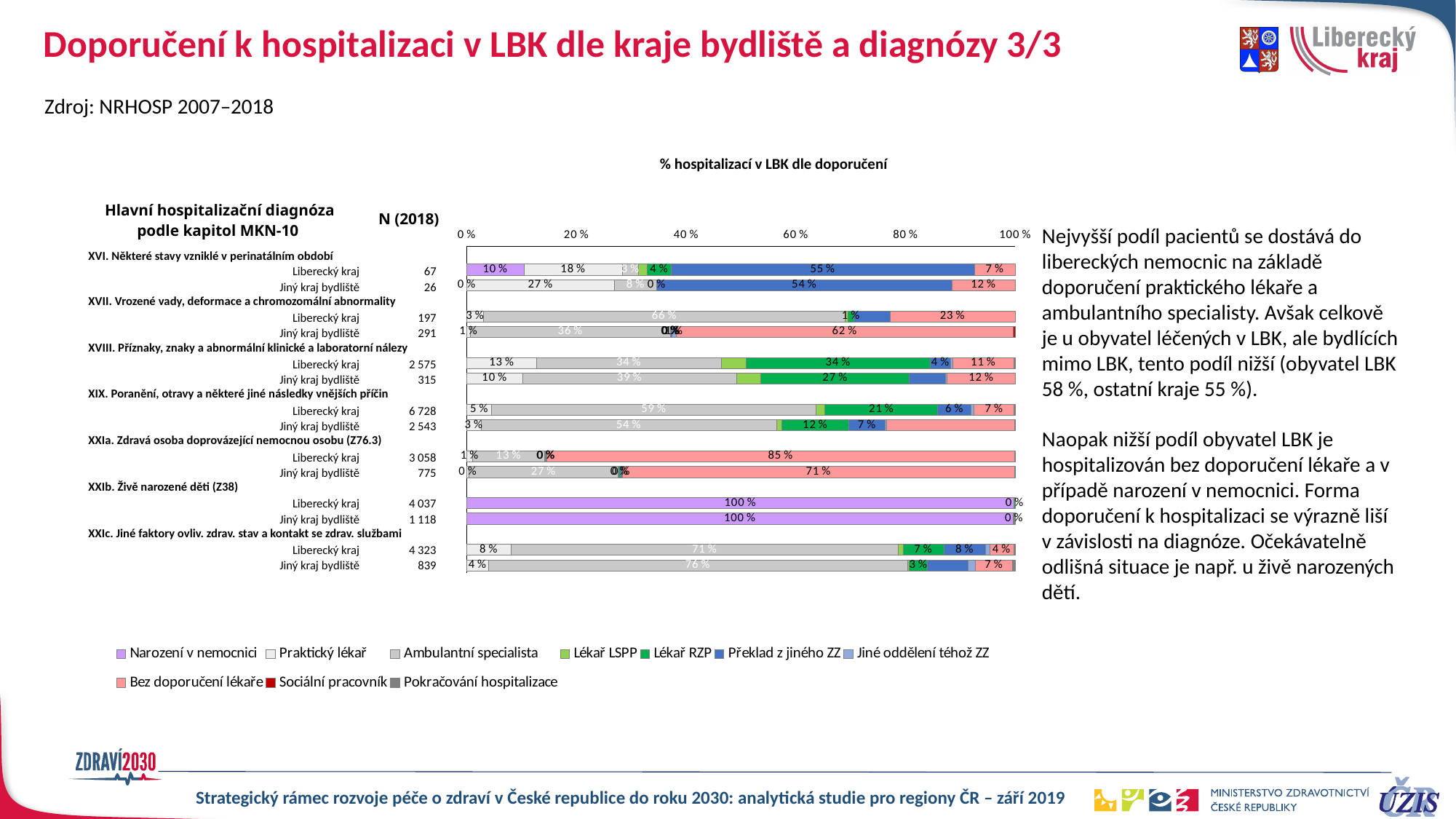
How many series does the chart legend list? 10 What is the Bez doporučení lékaře share for XXIa. Zdravá osoba doprovázející nemocnou osobu (Z76.3), Liberecký kraj? 85 % What is the Lékař RZP share for XVIII. Příznaky, znaky a abnormální klinické a laboratorní nálezy, Liberecký kraj? 34 % Which has the larger Ambulantní specialista share: XIX. Poranění, Liberecký kraj or XIX. Poranění, Jiný kraj bydliště? Liberecký kraj What share of hospitalizations for XXIb. Živě narozené děti (Z38), Liberecký kraj, is labelled as Narození v nemocnici? 100 % What is the Ambulantní specialista share for XXIc. Jiné faktory, Jiný kraj bydliště? 76 % What kind of chart is shown on the slide? Stacked bar chart Which has the larger Bez doporučení lékaře share: XVII. Vrozené vady, Liberecký kraj or XVII. Vrozené vady, Jiný kraj bydliště? Jiný kraj bydliště What is the title of the chart? % hospitalizací v LBK dle doporučení What is the Překlad z jiného ZZ share for XVI. Některé stavy vzniklé v perinatálním období, Liberecký kraj? 55 % What is the Bez doporučení lékaře share for XXIa. Zdravá osoba doprovázející nemocnou osobu (Z76.3), Jiný kraj bydliště? 71 % What is the difference between the Bez doporučení lékaře share for XXIa Liberecký kraj (85 %) and XXIa Jiný kraj bydliště (71 %)? 14 %